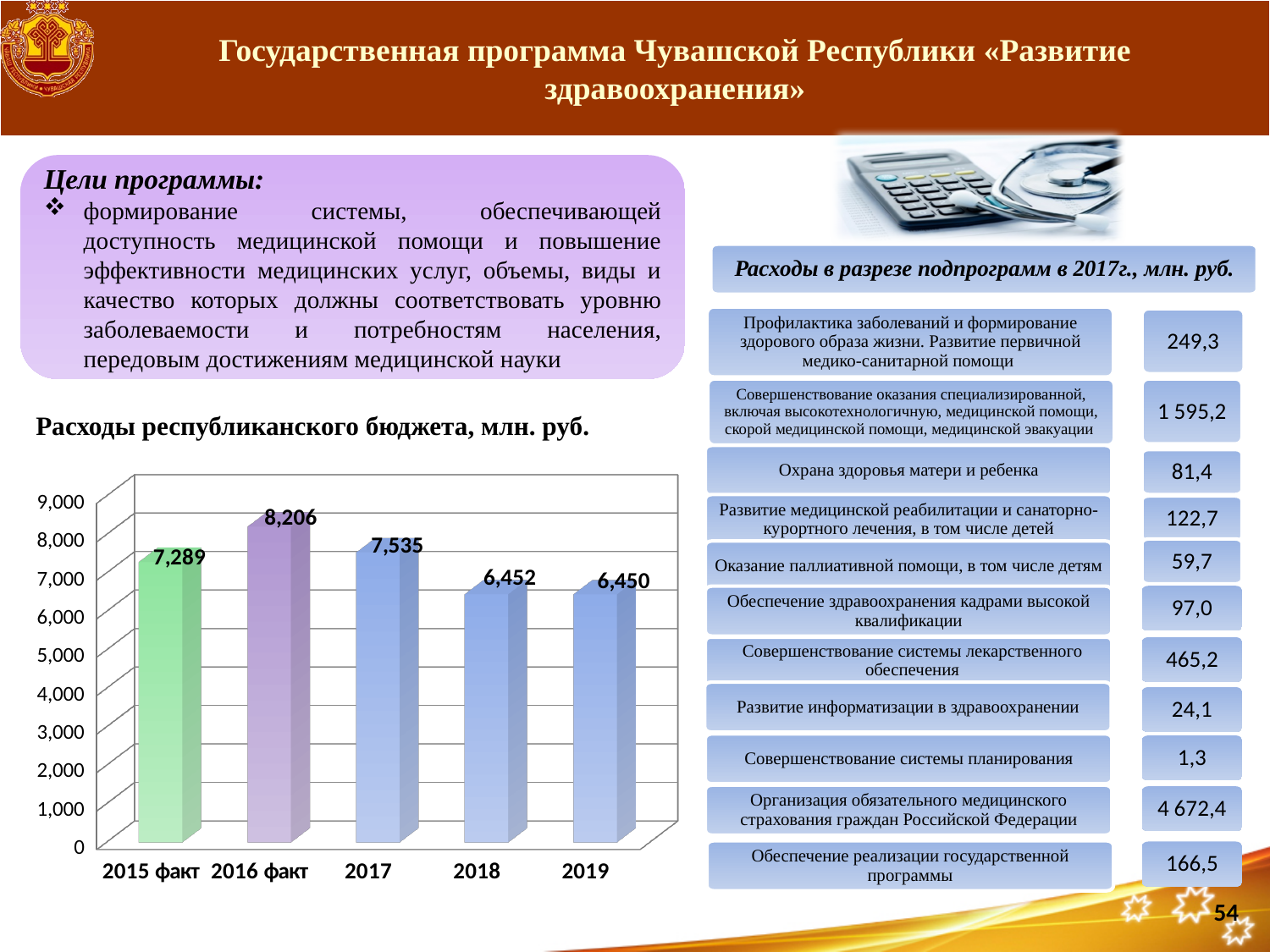
Do the values rise or fall from 2016 факт to 2019? fall What kind of chart is shown on the slide? bar chart What is the difference between the values for 2016 факт and 2015 факт? 917 What is the value shown for 2017 in the chart? 7,535 What is the difference between the values for 2017 and 2018? 1,083 What is the value for 2016 факт in the chart? 8,206 Is the value for 2019 greater or less than 7,000? less Which is larger, the value for 2017 or the value for 2015 факт? 2017 Which category has the highest value in the chart? 2016 факт How many categories are shown on the x axis of the chart? 5 What is the value for 2015 факт in the chart 'Расходы республиканского бюджета, млн. руб.'? 7,289 What is the value shown for 2018 in the chart? 6,452